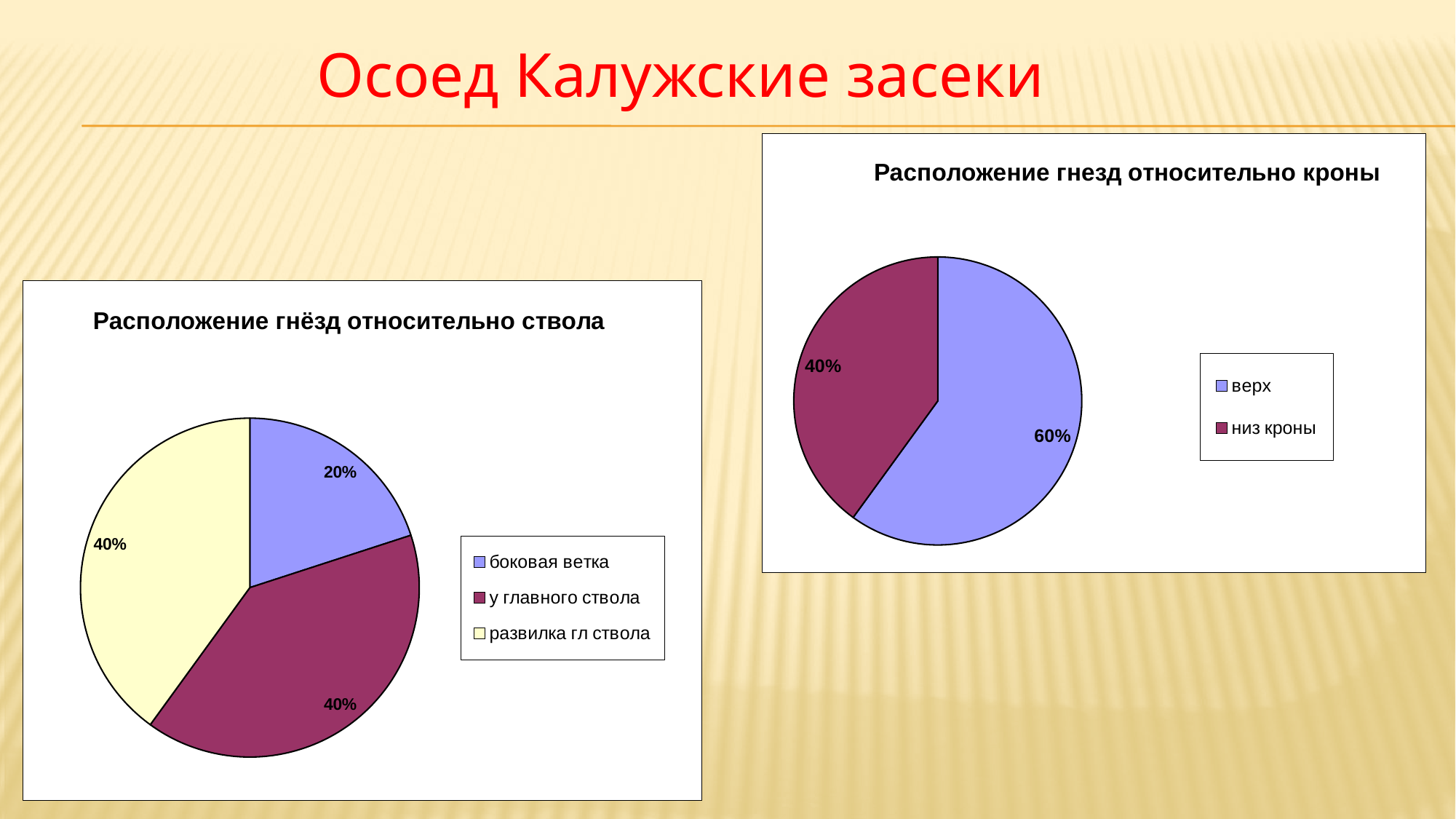
In the chart titled "Расположение гнезд относительно кроны", what share of the pie is "верх"? 60% In the chart titled "Расположение гнёзд относительно ствола", what share of the pie is "развилка гл ствола"? 40% In the chart titled "Расположение гнёзд относительно ствола", what share of the pie is "у главного ствола"? 40% In the chart titled "Расположение гнёзд относительно ствола", how many slices does the pie have? 3 In the chart titled "Расположение гнезд относительно кроны", how many entries does the legend list? 2 In the chart titled "Расположение гнёзд относительно ствола", what is the difference between the share for "у главного ствола" and the share for "боковая ветка"? 20% In the chart titled "Расположение гнезд относительно кроны", what colour is the slice for "низ кроны"? dark purple In the chart titled "Расположение гнёзд относительно ствола", what type of chart is shown? pie chart In the chart titled "Расположение гнезд относительно кроны", which category has the largest slice? верх In the chart titled "Расположение гнёзд относительно ствола", which category has the smallest slice? боковая ветка